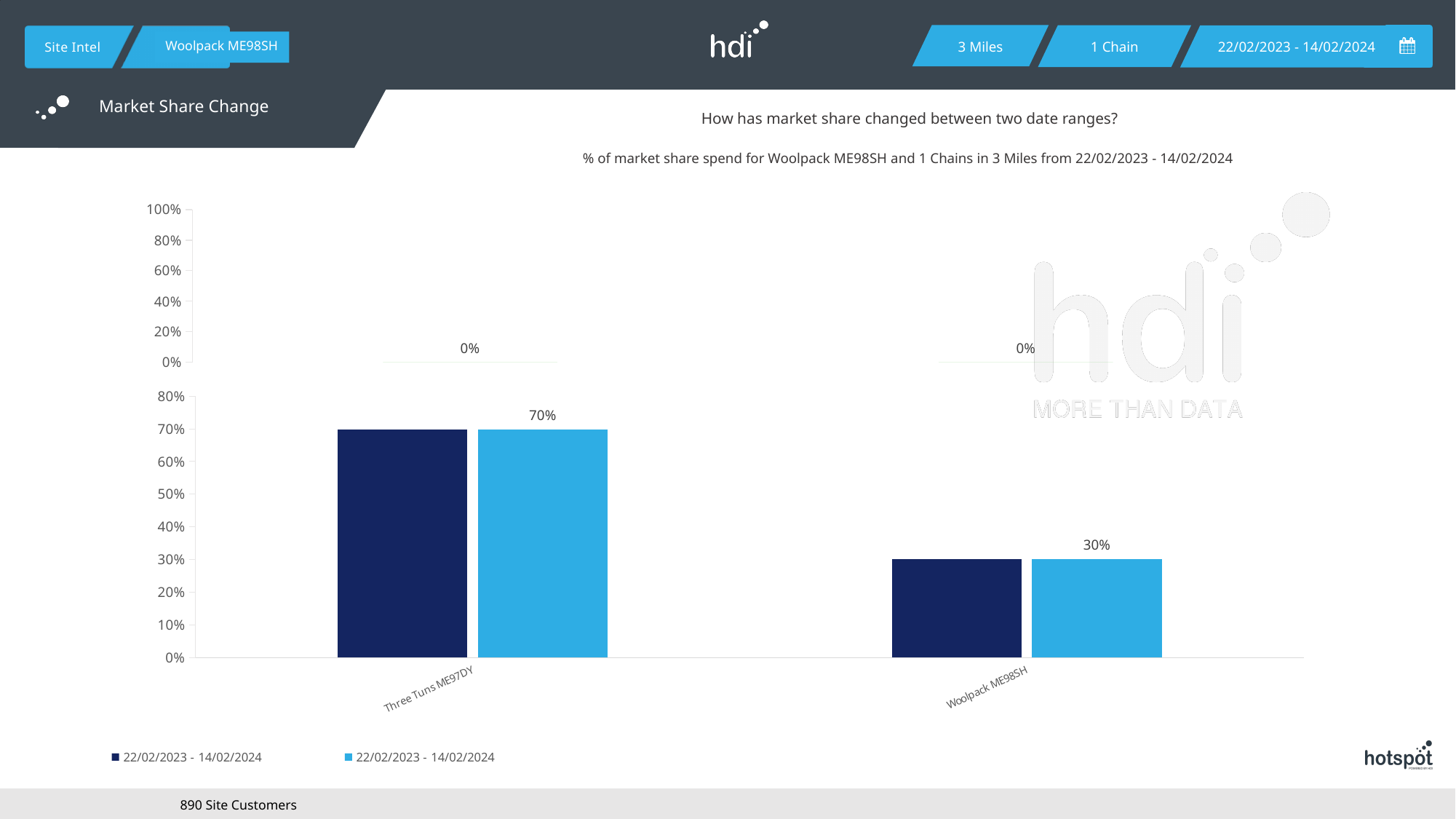
How many categories are shown on the x axis of the lower bar chart? 2 What is the labelled market share value for Three Tuns ME97DY in the light blue series? 70% How many series does the legend list? 2 What is the difference between the labelled light blue values for Three Tuns ME97DY and Woolpack ME98SH? 40% Which category has the highest market share in the lower bar chart? Three Tuns ME97DY Is the market share for Three Tuns ME97DY greater or less than 60%? greater What type of chart is shown on the slide? bar chart Is the market share for Woolpack ME98SH greater or less than 50%? less What date range is shown in the legend entries? 22/02/2023 - 14/02/2024 What market share change value is labelled for Three Tuns ME97DY in the upper chart? 0% What is the labelled market share value for Woolpack ME98SH in the light blue series? 30% Which category has the lowest market share in the lower bar chart? Woolpack ME98SH